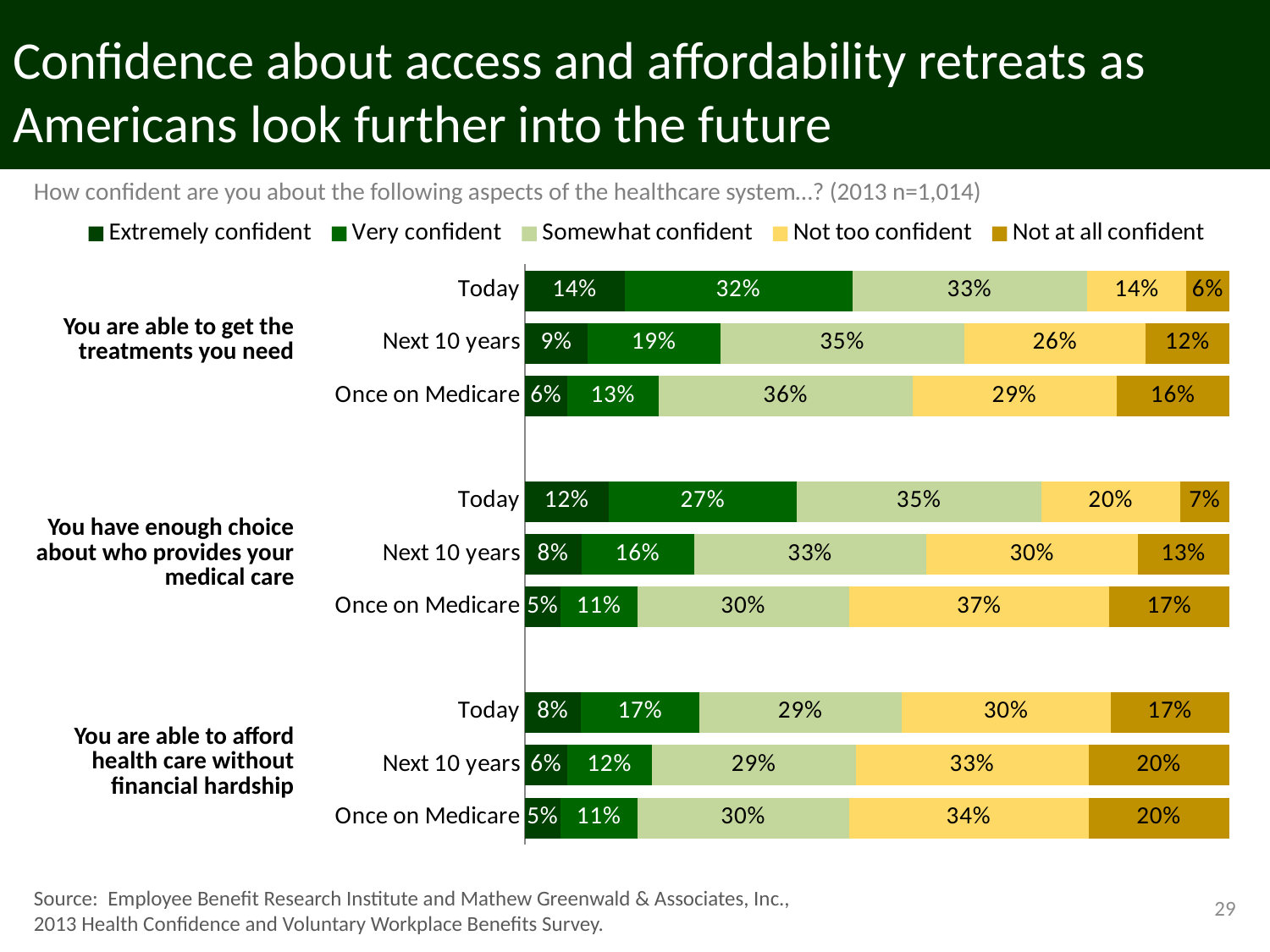
Which is larger: the 'Somewhat confident' share for getting needed treatments in the next 10 years, or the 'Somewhat confident' share for affording health care in the next 10 years? Getting needed treatments in the next 10 years For 'You have enough choice about who provides your medical care' today, what is the combined share of 'Extremely confident' and 'Very confident'? 39% How many bars are plotted in the chart in total? 9 For 'You have enough choice about who provides your medical care', which time frame has the highest 'Not too confident' share? Once on Medicare What kind of chart is shown on the slide? Stacked bar chart What percentage are somewhat confident about having enough choice about who provides their medical care in the next 10 years? 33% What percentage of respondents are extremely confident that they are able to get the treatments they need today? 14% How many confidence levels does the legend list? 5 For 'You are able to get the treatments you need', how much larger is the 'Very confident' share for Today than for Once on Medicare? 19 percentage points What percentage are not at all confident about being able to afford health care without financial hardship once on Medicare? 20% For 'You are able to afford health care without financial hardship', does the 'Extremely confident' share rise or fall from Today to Next 10 years to Once on Medicare? Fall For 'You are able to get the treatments you need', which time frame has the lowest 'Extremely confident' share? Once on Medicare